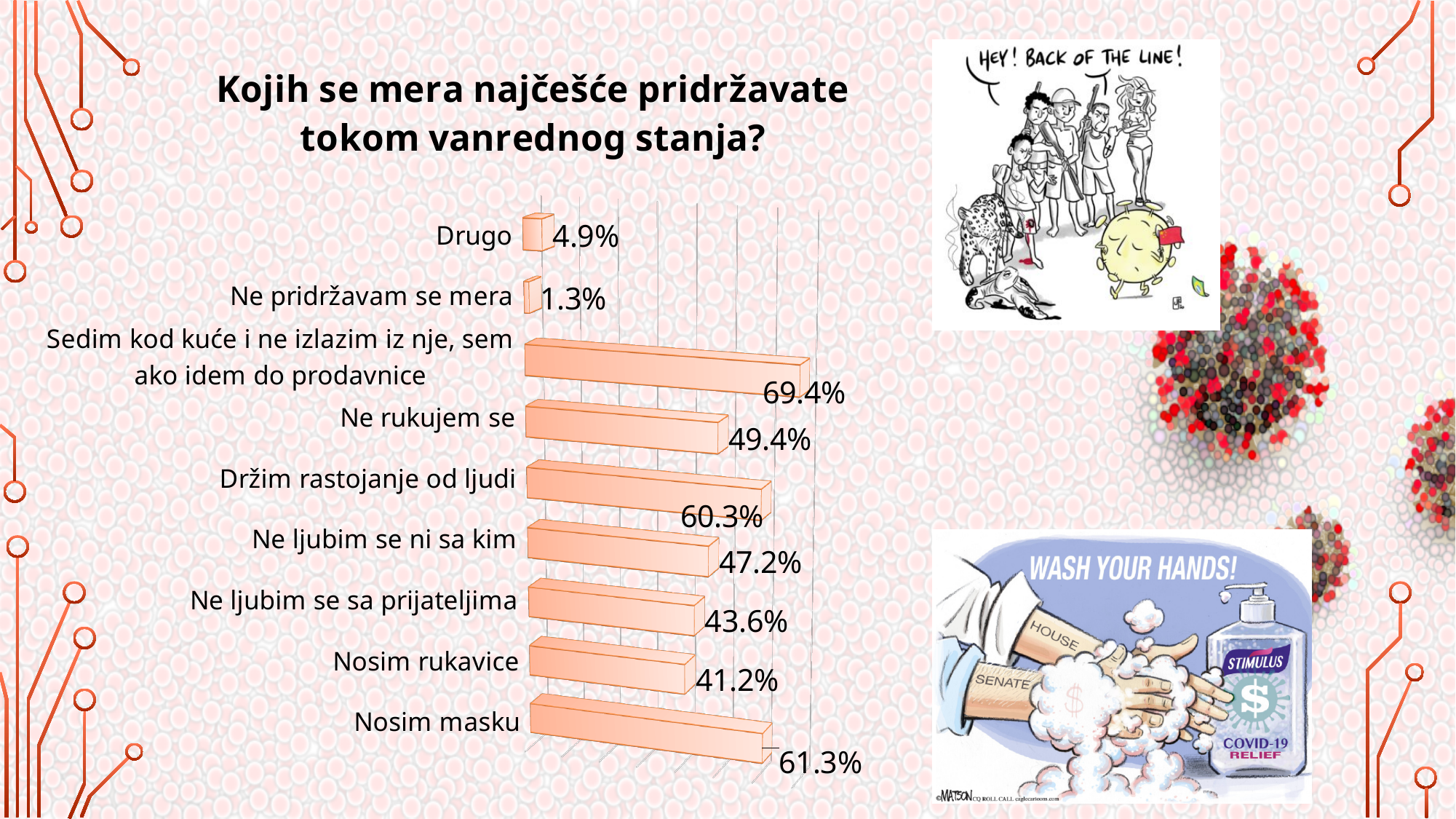
What is the value for "Nosim rukavice"? 41.2% What kind of chart is shown on the slide? bar chart Which category has the lowest value? Ne pridržavam se mera How many categories does the chart show? 9 What is the value for "Drugo"? 4.9% What is the value for "Ne rukujem se"? 49.4% What is the difference between the values for "Sedim kod kuće i ne izlazim iz nje, sem ako idem do prodavnice" and "Nosim masku"? 8.1% What is the value for "Nosim masku"? 61.3% Which is larger, the value for "Ne ljubim se ni sa kim" or the value for "Ne ljubim se sa prijateljima"? Ne ljubim se ni sa kim What is the title of the chart? Kojih se mera najčešće pridržavate tokom vanrednog stanja? What is the difference between the values for "Drugo" and "Ne pridržavam se mera"? 3.6% Which category has the highest value? Sedim kod kuće i ne izlazim iz nje, sem ako idem do prodavnice